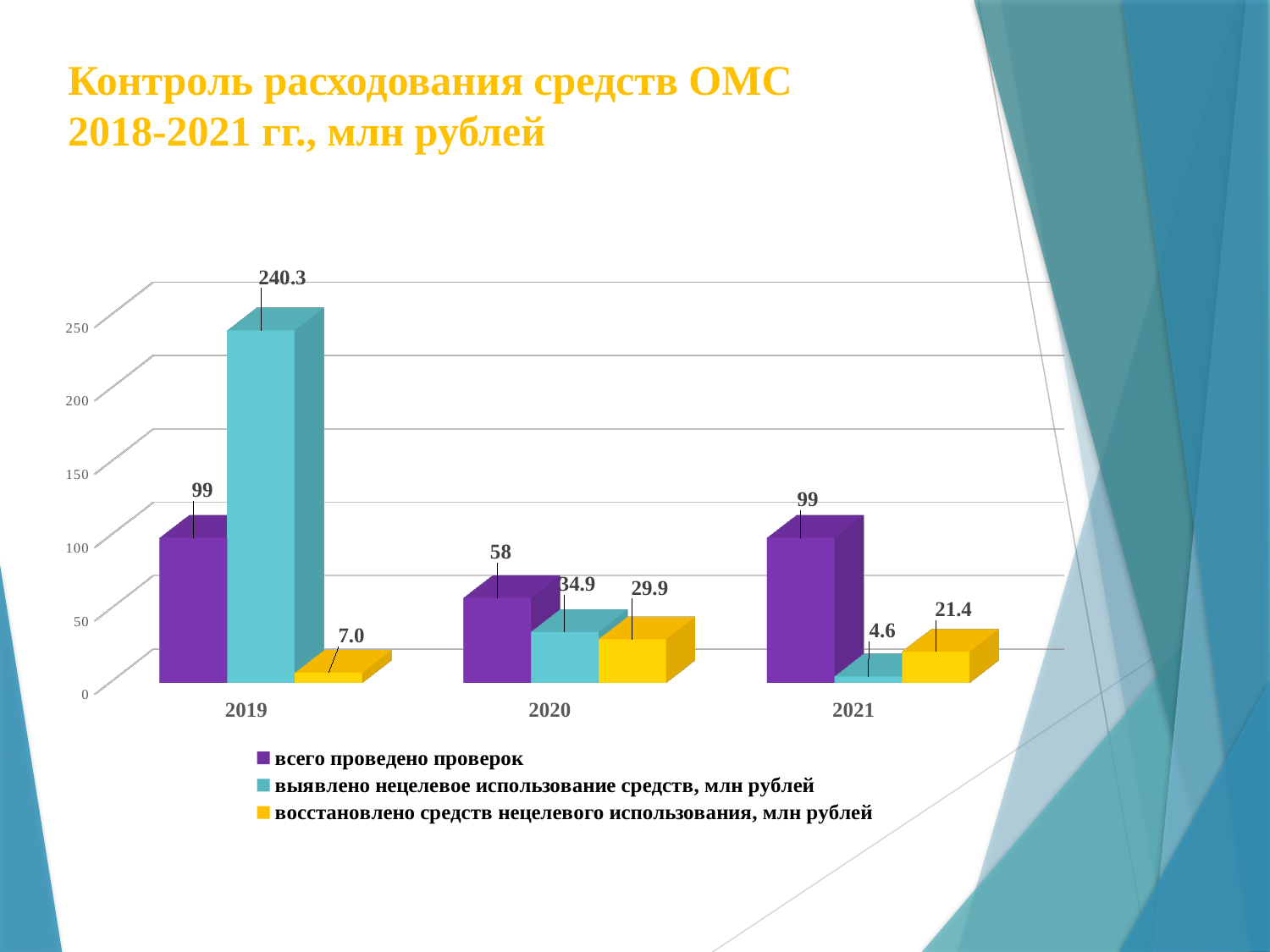
In which year is the value of "восстановлено средств нецелевого использования, млн рублей" lowest? 2019 What is the value of "восстановлено средств нецелевого использования, млн рублей" for 2021? 21.4 Which is larger in 2021: "выявлено нецелевое использование средств" or "восстановлено средств нецелевого использования"? восстановлено средств нецелевого использования What kind of chart is shown on the slide? bar chart What is the value of "всего проведено проверок" for 2020? 58 Is the value of "выявлено нецелевое использование средств" for 2019 greater or less than 200? greater What is the value of "выявлено нецелевое использование средств, млн рублей" for 2021? 4.6 In which year is the value of "выявлено нецелевое использование средств, млн рублей" highest? 2019 How many years are shown on the x axis of the chart? 3 What is the difference between "выявлено нецелевое использование средств" and "восстановлено средств нецелевого использования" in 2020? 5.0 What is the value of "выявлено нецелевое использование средств, млн рублей" for 2019? 240.3 How many series does the legend list? 3